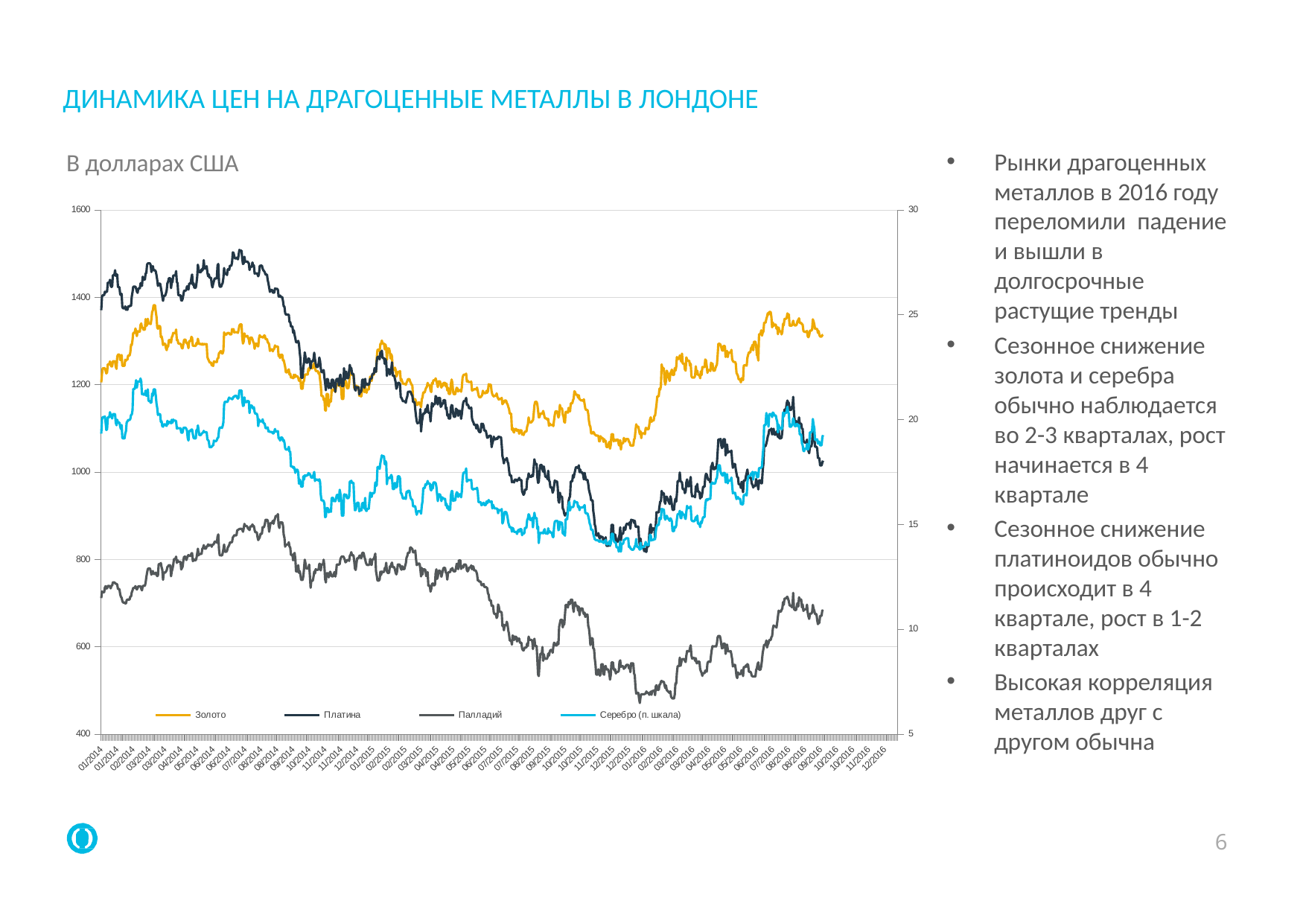
Is the value for Палладий at 01/2014 greater or less than 600? greater Which series in the legend is plotted on the right-hand scale? Серебро (п. шкала) Is the value for Палладий at 01/2016 greater or less than 600? less At 01/2014, which is higher: Платина or Золото? Платина How many series does the chart legend list? 4 Is the value for Платина at 01/2014 greater or less than 1200? greater Does the Платина line rise or fall overall from 01/2014 to 09/2016? Fall What is the title of the chart on the slide? ДИНАМИКА ЦЕН НА ДРАГОЦЕННЫЕ МЕТАЛЛЫ В ЛОНДОНЕ At 09/2016, which is higher: Золото or Платина? Золото Does the Золото line rise or fall from 01/2016 to 07/2016? Rise What kind of chart is shown on the slide? Line chart